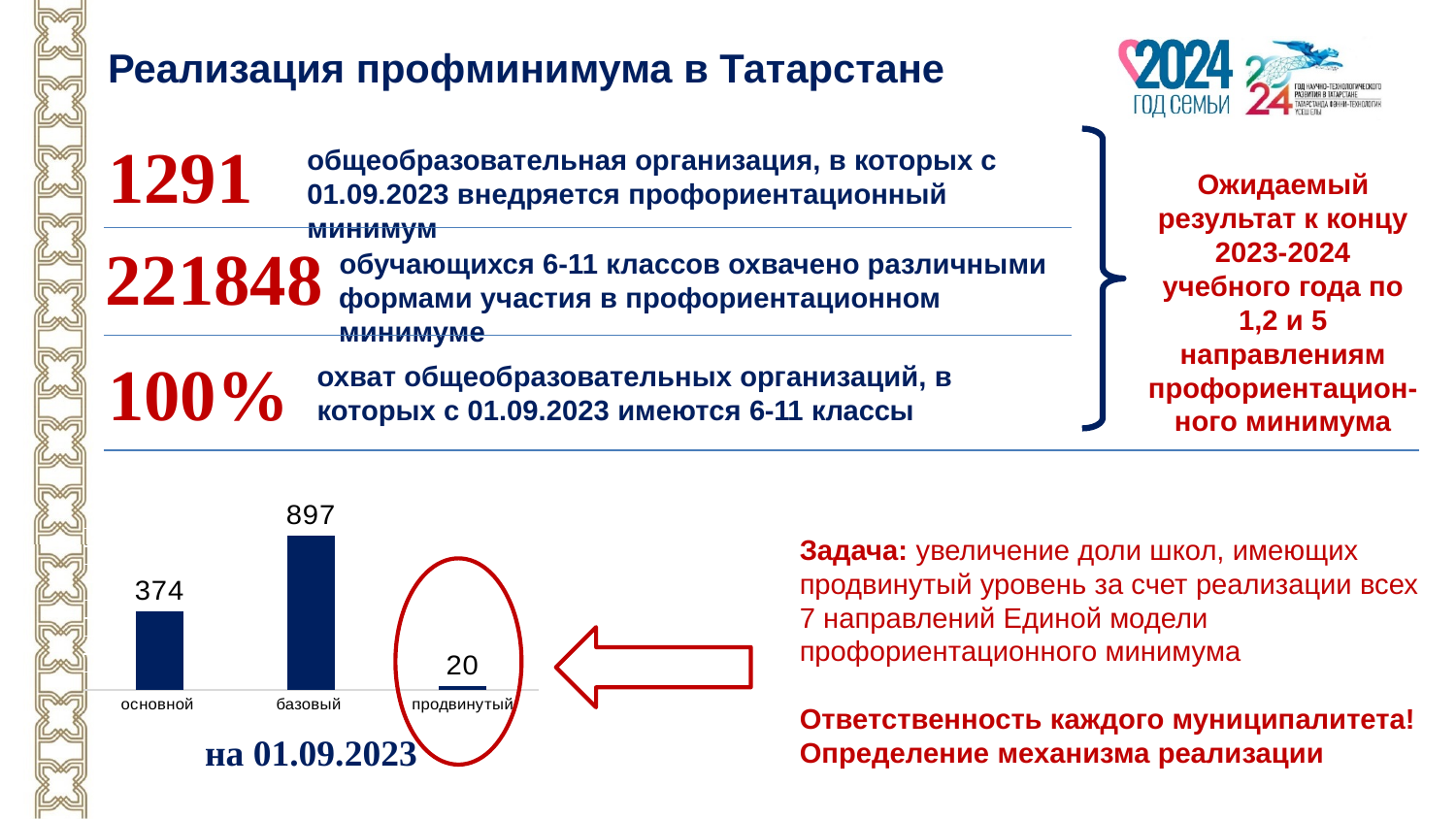
What is the value for the 'основной' category in the bar chart? 374 What is the difference between the values for 'базовый' and 'основной' in the bar chart? 523 What is the total of all three bars in the bar chart? 1291 How many categories are shown in the bar chart? 3 Which is larger in the bar chart: the value for 'основной' or the value for 'продвинутый'? основной What is the value for the 'продвинутый' category in the bar chart? 20 What is the difference between the values for 'основной' and 'продвинутый' in the bar chart? 354 What is the value for the 'базовый' category in the bar chart? 897 What date caption is written under the bar chart? на 01.09.2023 Which category has the highest value in the bar chart? базовый What kind of chart is shown on the slide? bar chart Which category has the lowest value in the bar chart? продвинутый